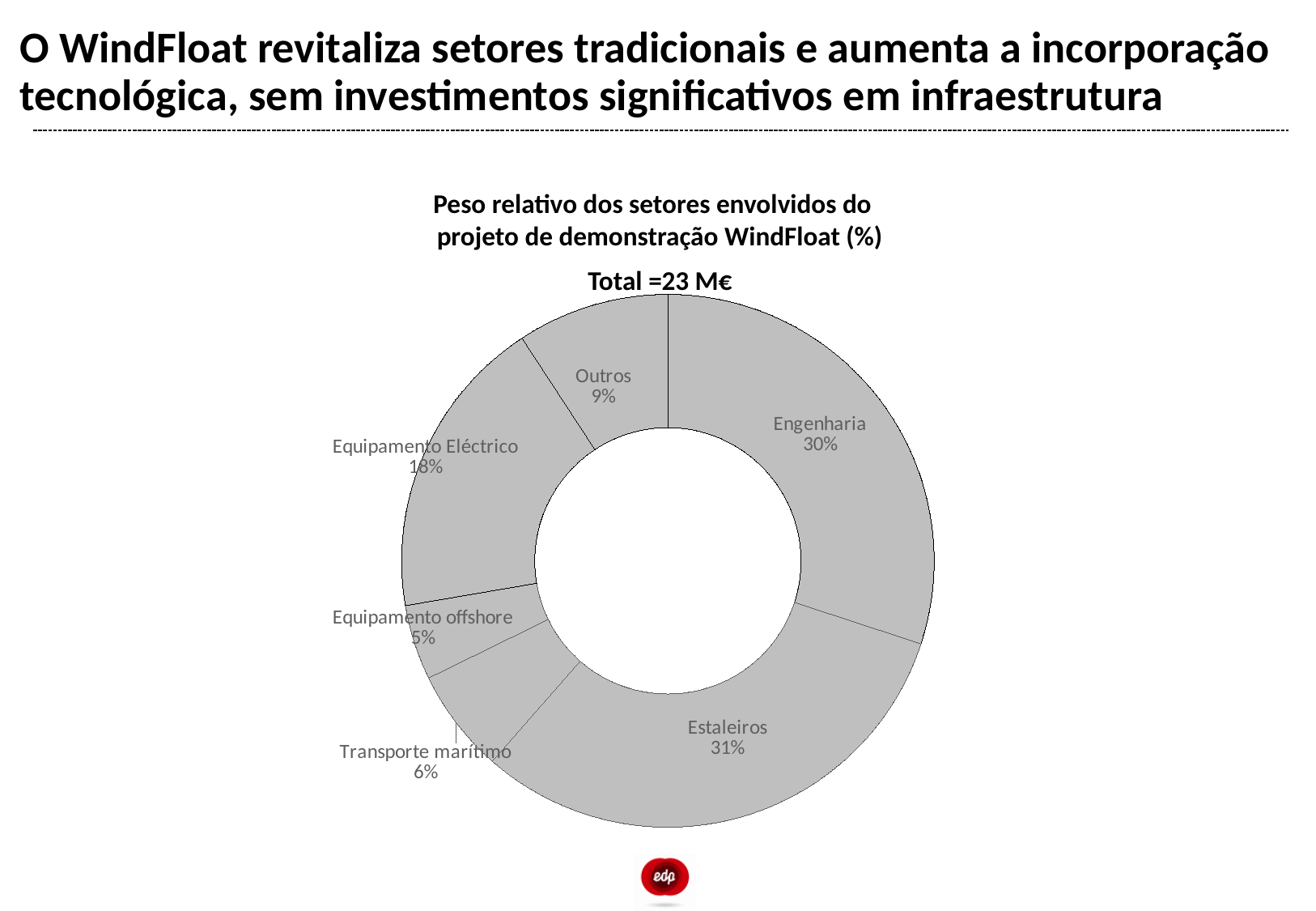
What share of the doughnut chart does Engenharia represent? 30% What is the difference in percentage points between Equipamento Eléctrico and Outros? 9 percentage points How many sectors are shown in the chart? 6 Which sector has the largest share in the chart? Estaleiros What total amount is stated above the chart? Total =23 M€ What percentage is shown for Outros? 9% Which sector has the smallest share in the chart? Equipamento offshore Which has a larger share, Engenharia or Equipamento Eléctrico? Engenharia What percentage is shown for Estaleiros? 31% What percentage is shown for Equipamento Eléctrico? 18% What percentage is shown for Transporte marítimo? 6% What kind of chart is shown on the slide? Doughnut chart